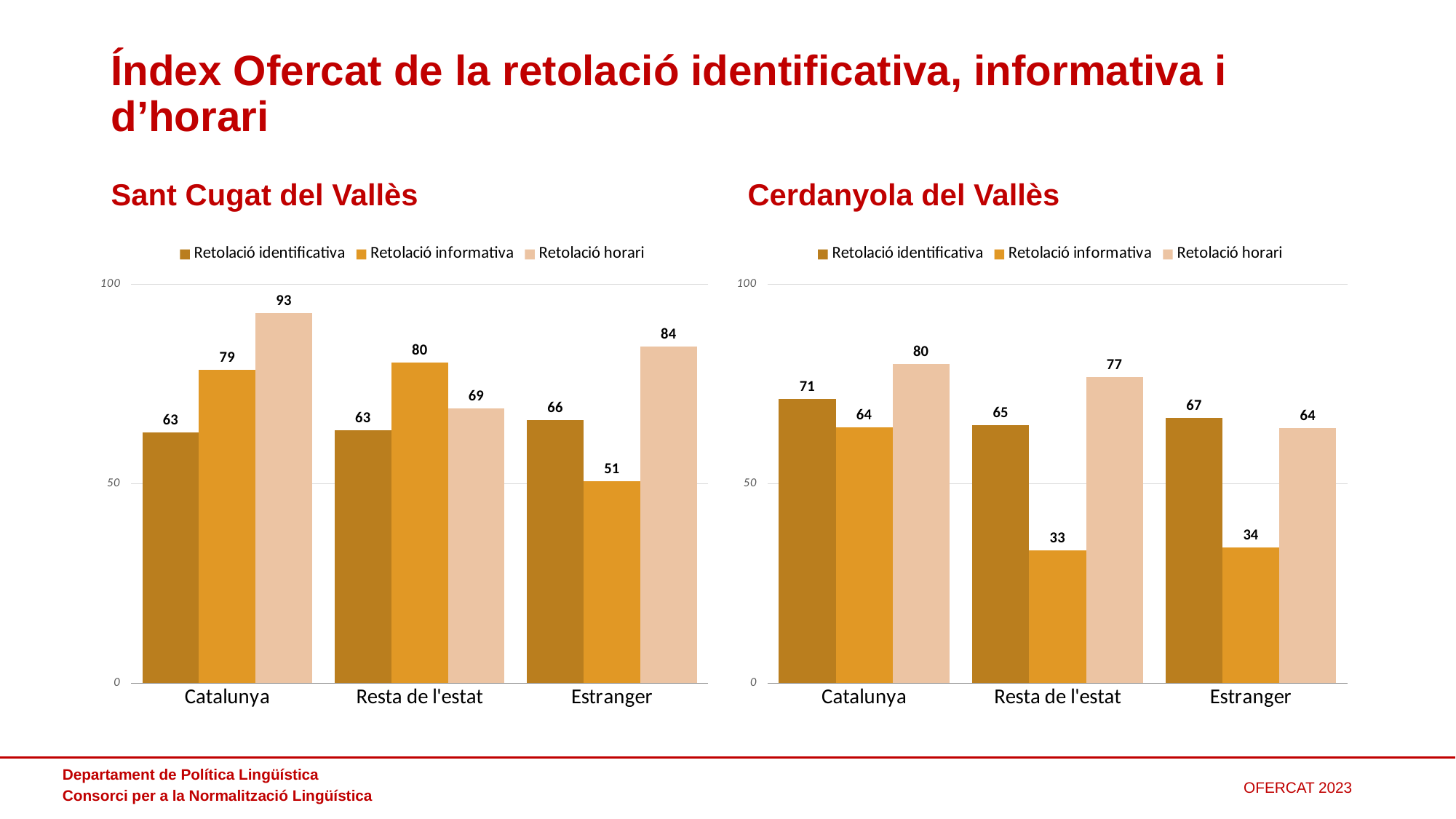
In the Cerdanyola del Vallès chart, what is the value of Retolació informativa for Resta de l'estat? 33 What kind of chart is the Cerdanyola del Vallès chart? Bar chart How many series does the legend of the Sant Cugat del Vallès chart list? 3 In the Sant Cugat del Vallès chart, what is the difference between Retolació horari and Retolació identificativa for Catalunya? 30 In the Cerdanyola del Vallès chart, which is larger for Estranger: Retolació identificativa or Retolació horari? Retolació identificativa In the Sant Cugat del Vallès chart, is the value of Retolació informativa for Estranger greater or less than 50? greater In the Sant Cugat del Vallès chart, what is the value of Retolació horari for Catalunya? 93 How many categories are shown on the x axis of the Cerdanyola del Vallès chart? 3 In the Cerdanyola del Vallès chart, which category has the highest value for Retolació identificativa? Catalunya In the Sant Cugat del Vallès chart, which category has the lowest value for Retolació horari? Resta de l'estat In the Cerdanyola del Vallès chart, what is the difference between Retolació horari and Retolació informativa for Resta de l'estat? 44 In the Sant Cugat del Vallès chart, what is the value of Retolació informativa for Estranger? 51